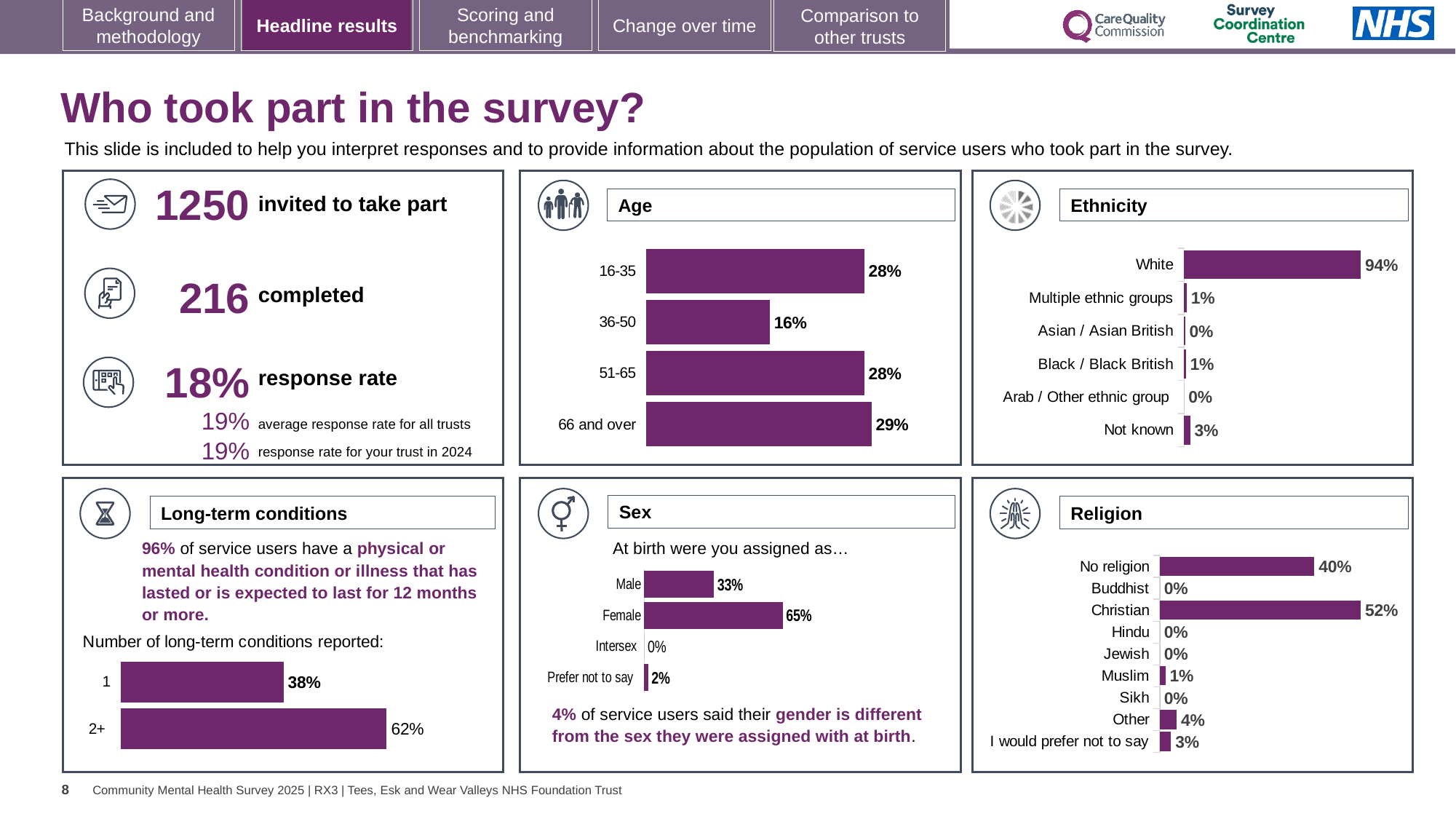
In the Age chart, which age group has the highest percentage? 66 and over In the Sex chart, what is the difference between the Female and Male percentages? 32% In the Age chart, what percentage of respondents were aged 36-50? 16% In the Age chart, how many age categories are shown? 4 In the Religion chart, how many categories are listed? 9 In the Sex chart, which is larger, Male or Female? Female In the Ethnicity chart, what percentage of respondents were Not known? 3% In the Religion chart, which category has the highest percentage? Christian What type of chart is used in the Age panel? Bar chart In the Ethnicity chart, what percentage of respondents were White? 94% In the Religion chart, what percentage of respondents said No religion? 40% In the Long-term conditions chart, what percentage of service users reported 2+ conditions? 62%